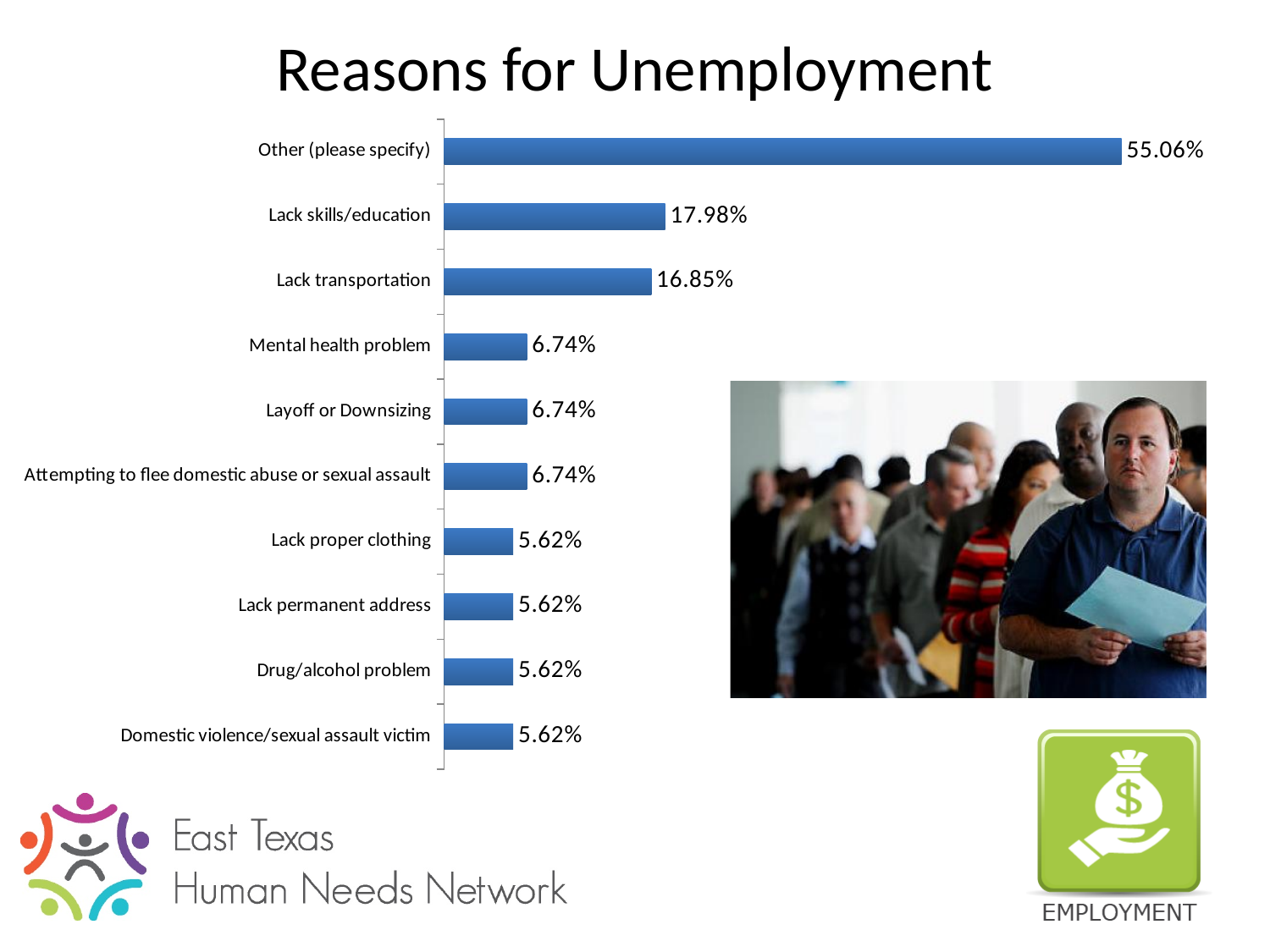
What is the value for Lack transportation? 16.85% Which category has the highest value? Other (please specify) What is the title of the chart? Reasons for Unemployment What is the value for Other (please specify)? 55.06% What is the value for Lack proper clothing? 5.62% What is the value for Lack skills/education? 17.98% How many categories are shown in the chart? 10 Which is larger, Lack transportation or Mental health problem? Lack transportation What is the difference between Lack skills/education and Lack transportation? 1.13% What is the value for Mental health problem? 6.74% What is the difference between Other (please specify) and Lack skills/education? 37.08% What kind of chart is shown on the slide? Bar chart